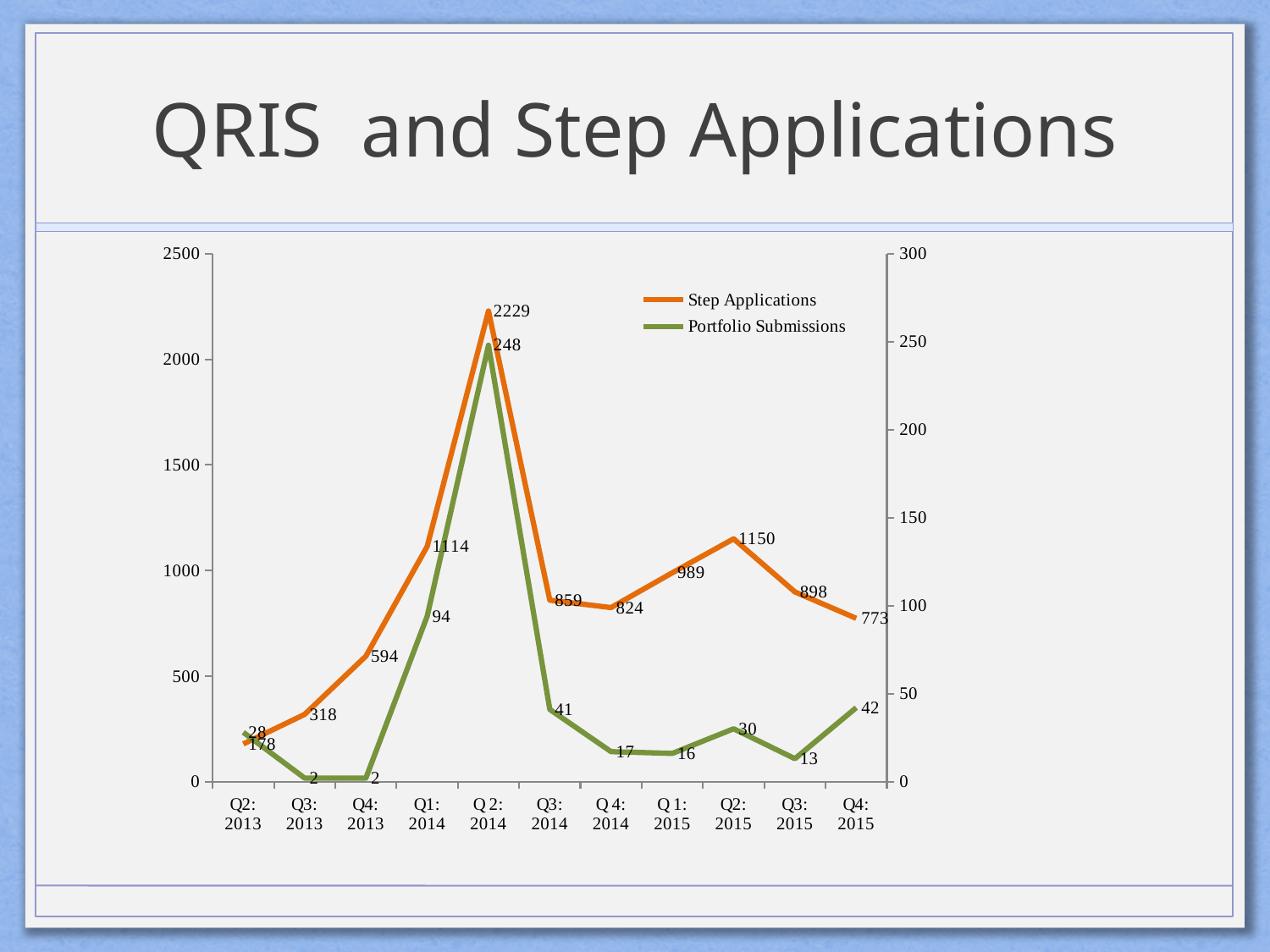
In which quarter are Step Applications lowest? Q2: 2013 Which colour is used for the Portfolio Submissions line? green What is the value of Portfolio Submissions in Q1: 2014? 94 In which quarter are Portfolio Submissions highest? Q2: 2014 What is the difference between Step Applications in Q2: 2015 and Q3: 2015? 252 What is the difference between Portfolio Submissions in Q4: 2015 and Q3: 2015? 29 How many quarters are plotted along the x axis? 11 What type of chart is shown on the slide? line chart What is the value of Step Applications in Q2: 2014? 2229 Which is larger for Step Applications: Q3: 2014 or Q1: 2015? Q1: 2015 How many series does the legend list? 2 Do Step Applications rise or fall from Q2: 2013 to Q2: 2014? rise